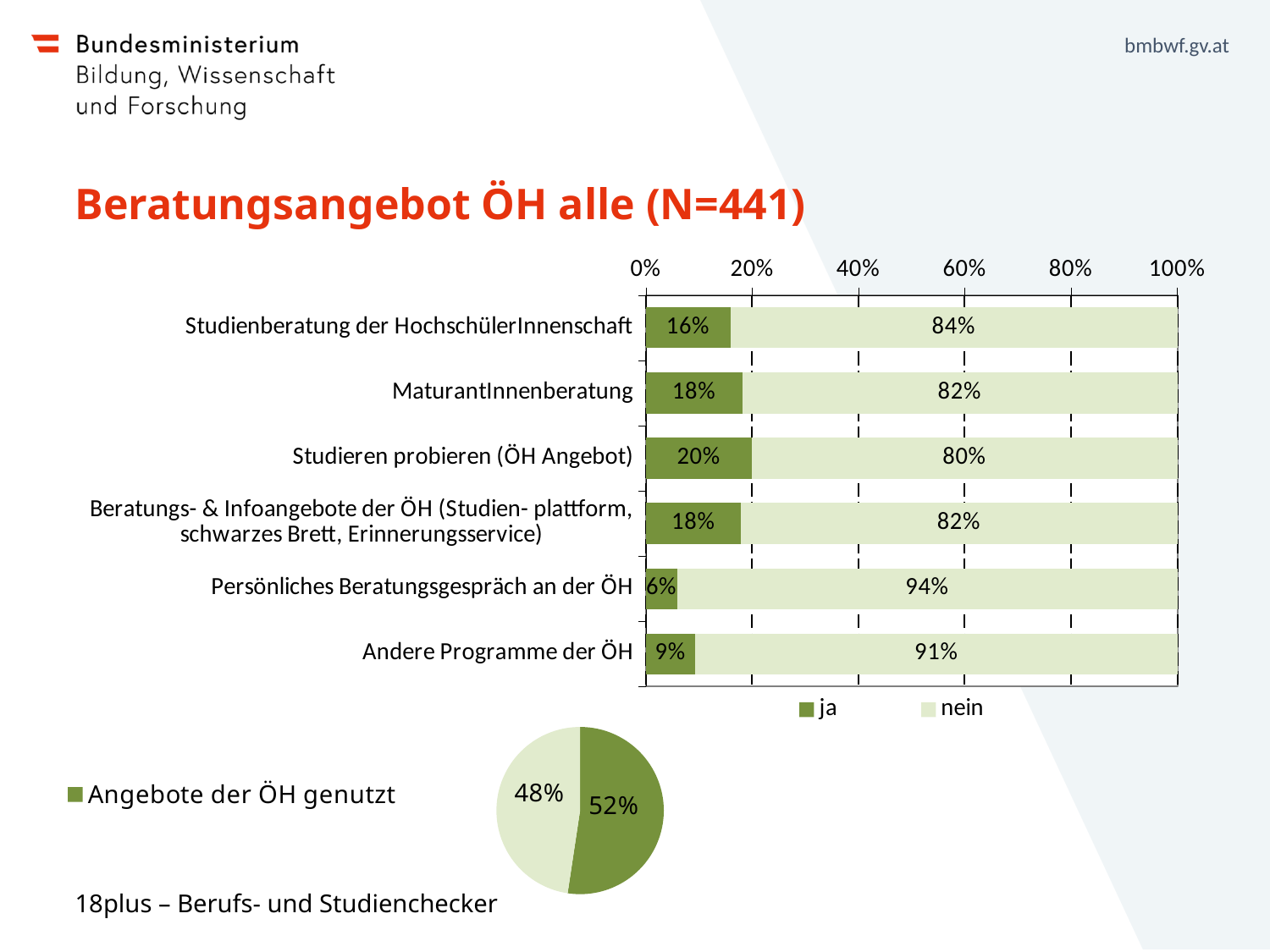
What type of chart is the chart at the bottom of the slide? Pie chart In the bar chart, what is the 'nein' value for Persönliches Beratungsgespräch an der ÖH? 94% How many categories does the bar chart show? 6 In the pie chart at the bottom of the slide, what share is shown for 'Angebote der ÖH genutzt'? 52% In the bar chart, what is the difference between the 'ja' values for Studieren probieren (ÖH Angebot) and Studienberatung der HochschülerInnenschaft? 4% In the bar chart, which category has the lowest 'ja' value? Persönliches Beratungsgespräch an der ÖH In the bar chart, which is larger: the 'ja' value for MaturantInnenberatung or for Andere Programme der ÖH? MaturantInnenberatung In the bar chart, what is the 'ja' value for Studieren probieren (ÖH Angebot)? 20% What type of chart is the chart at the top right of the slide? Bar chart In the bar chart, what is the 'ja' value for Andere Programme der ÖH? 9% In the bar chart, which category has the highest 'ja' value? Studieren probieren (ÖH Angebot) How many series does the bar chart legend list? 2